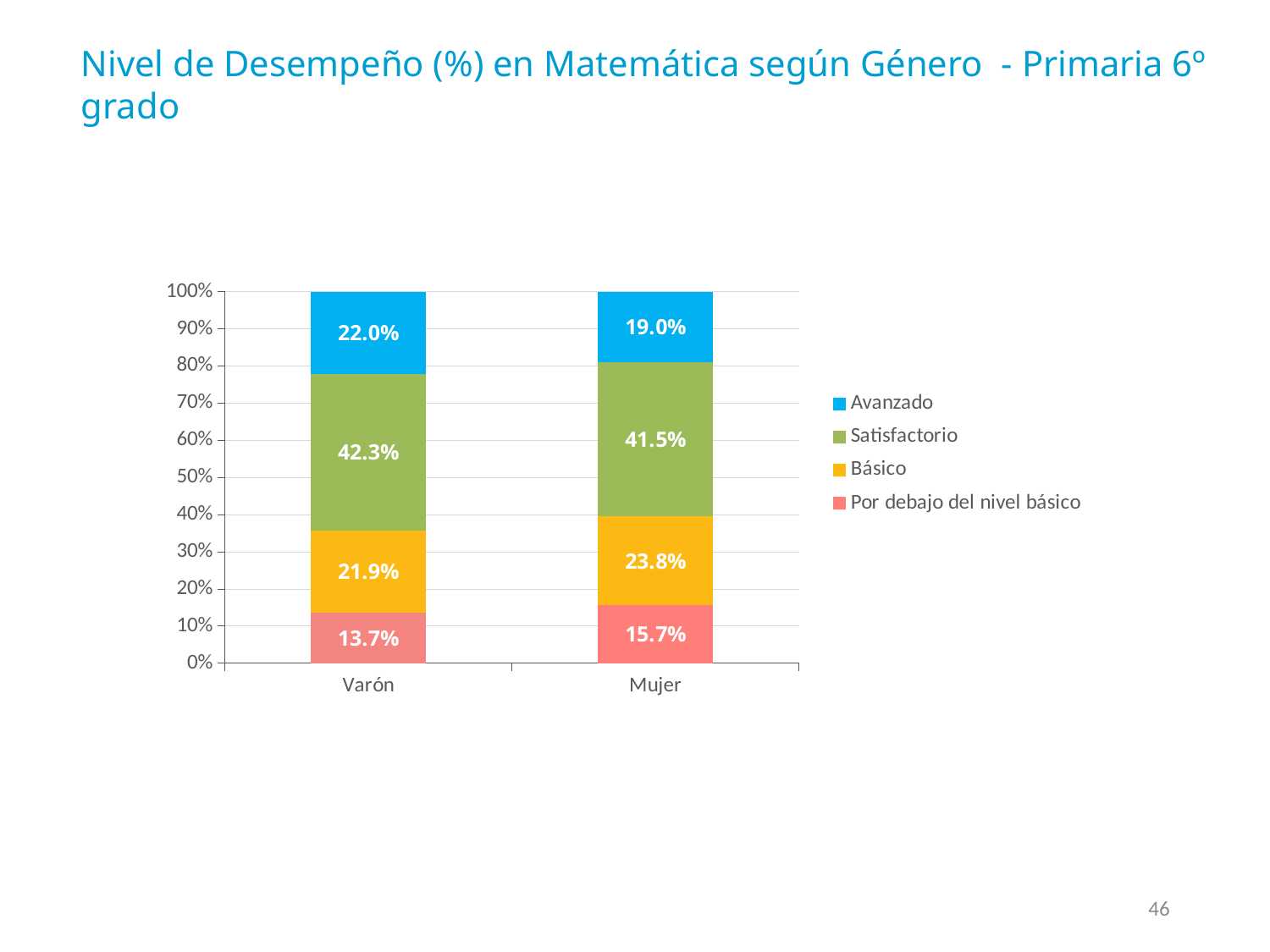
Which gender has the higher Por debajo del nivel básico value? Mujer What is the Básico value for Mujer? 23.8% Which level has the smallest share for Mujer? Por debajo del nivel básico Which gender has the higher Avanzado value? Varón What is the difference between the Avanzado values for Varón and Mujer? 3.0% What is the difference between the Básico values for Mujer and Varón? 1.9% Which level has the largest share for Varón? Satisfactorio What kind of chart is shown? Stacked bar chart How many series does the legend list? 4 What is the Por debajo del nivel básico value for Varón? 13.7% What is the Avanzado value for Varón? 22.0% What is the Satisfactorio value for Mujer? 41.5%